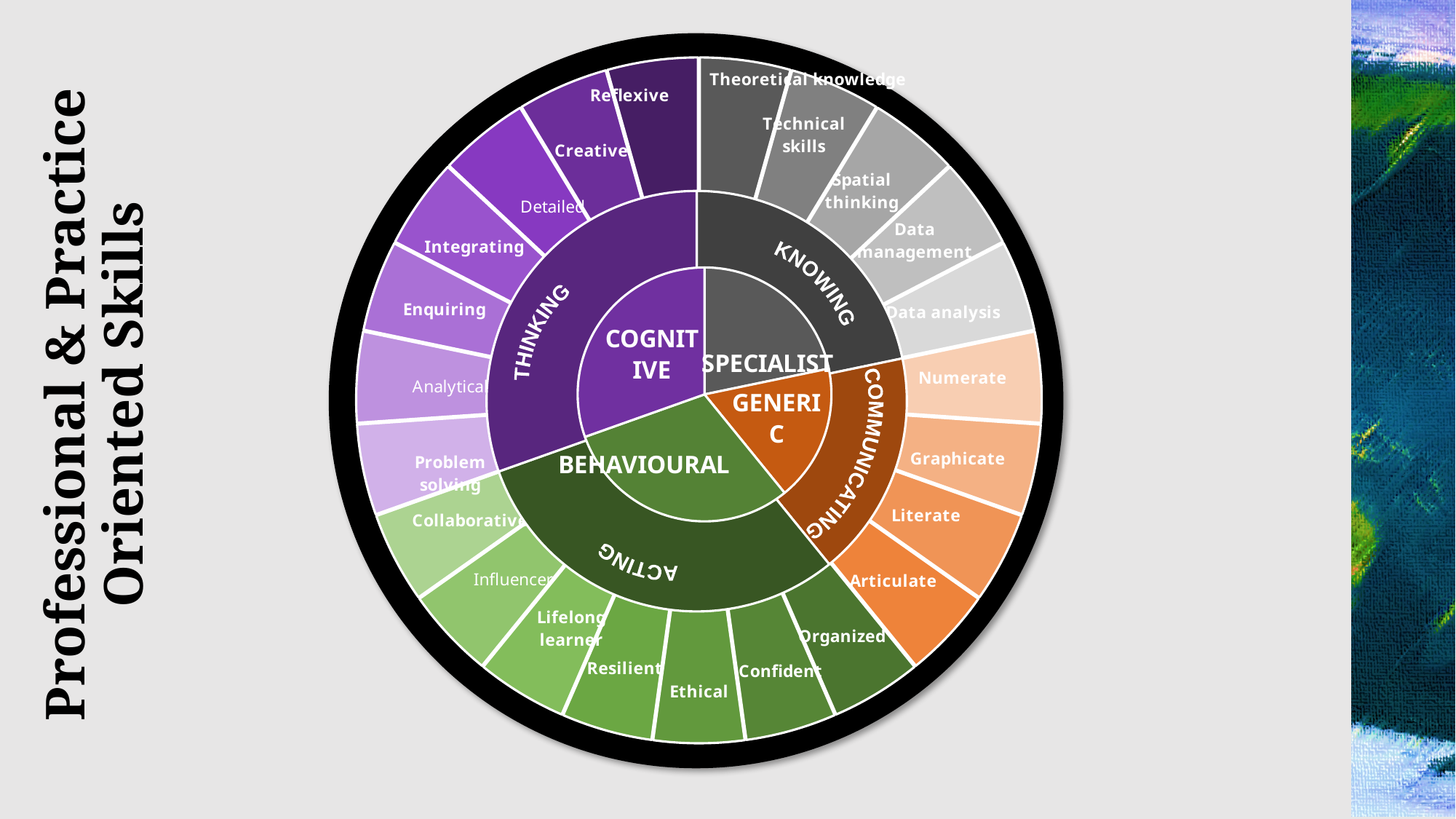
How many outer-ring segments sit under the ACTING segment? 7 What is the title of the slide containing the chart? Professional & Practice Oriented Skills How many outer-ring segments sit under the KNOWING segment? 5 Which middle-ring segment sits under the GENERIC segment? COMMUNICATING How many outer-ring segments sit under the COMMUNICATING segment? 4 What kind of chart is shown on the slide? Sunburst chart Which middle-ring segment sits under the COGNITIVE segment? THINKING What colour are the segments under the COMMUNICATING part of the chart? Orange Which inner-ring segment does the ACTING segment belong to? BEHAVIOURAL